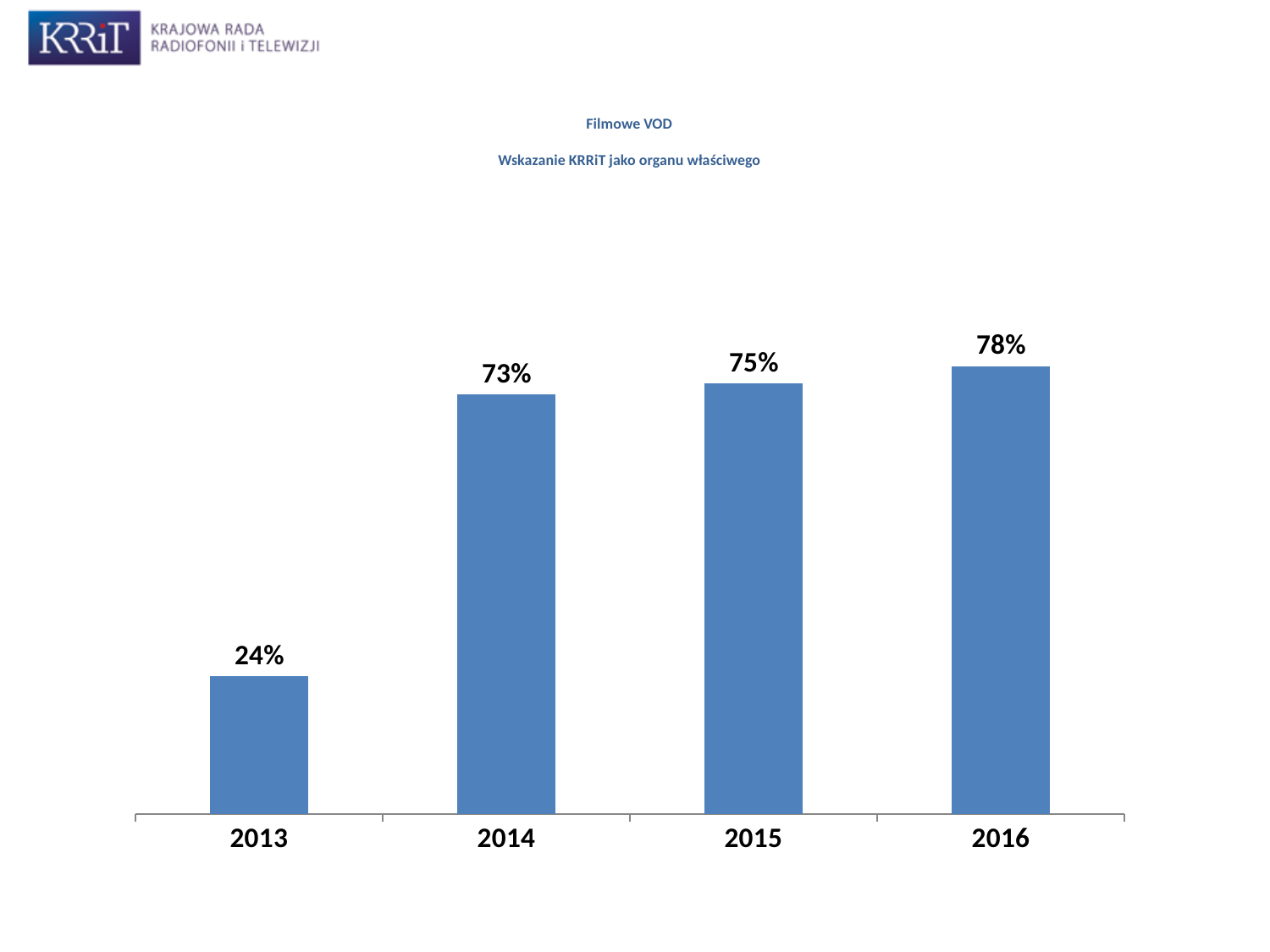
What is the value for 2015? 75% Which year has the lowest value? 2013 Which is larger, the value for 2014 or the value for 2013? 2014 Do the values rise or fall from 2013 to 2016? Rise What is the value for 2013? 24% Which year has the highest value? 2016 What kind of chart is shown on the slide? Bar chart How many years are shown on the x axis? 4 What is the difference between the values for 2015 and 2014? 2% What is the difference between the values for 2016 and 2013? 54% What is the value for 2016? 78% What is the value for 2014? 73%